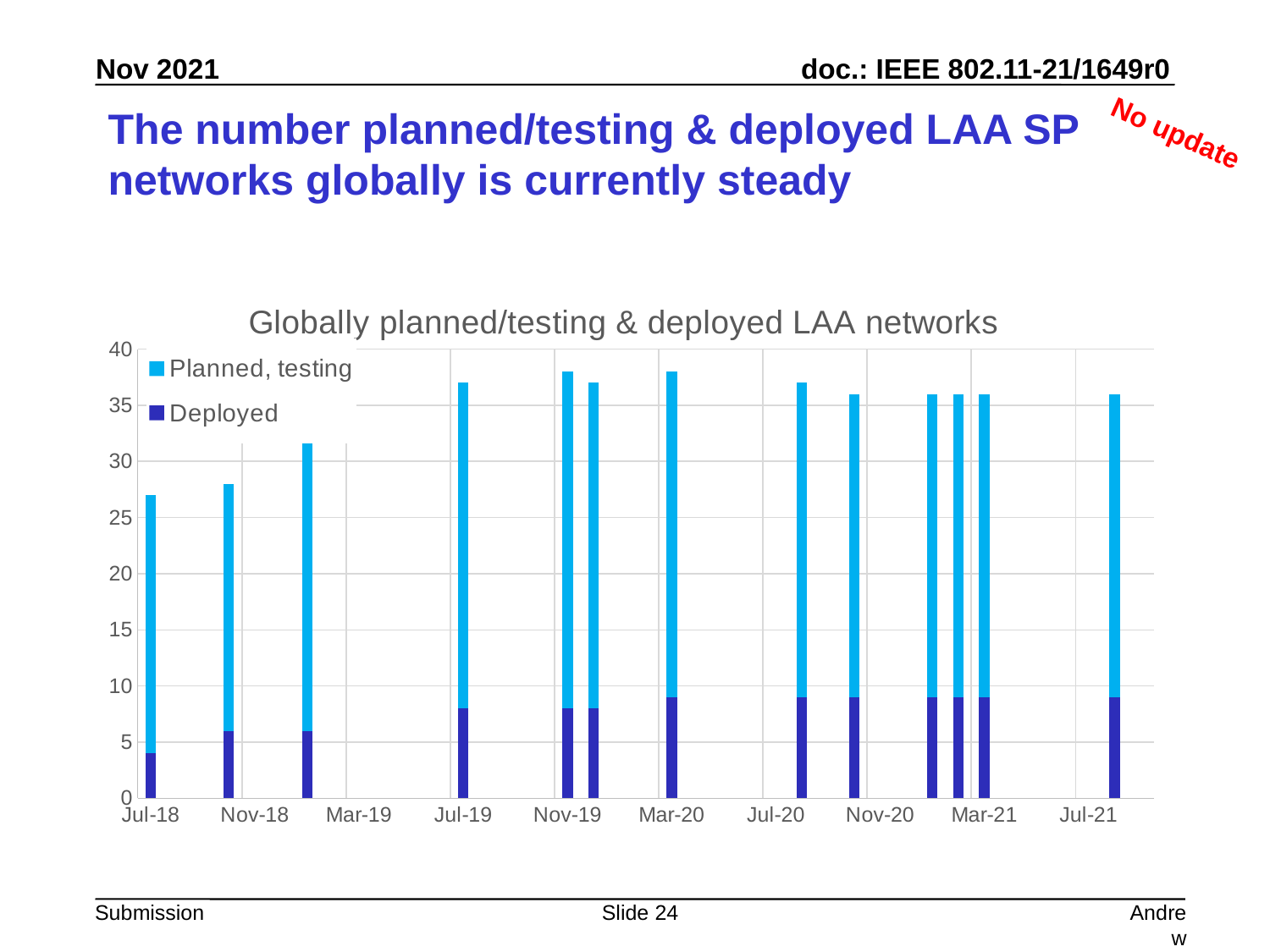
Which bar has the larger total, the one at Jul-18 or the one at Jul-19? Jul-19 How many date labels are shown along the x axis of the chart? 10 How many series does the chart legend list? 2 Is the total height of the bar at Jul-18 greater or less than 30? less Which series is shown in dark blue in the chart? Deployed What is the title of the chart? Globally planned/testing & deployed LAA networks Is the total height of the bar at Jul-19 greater or less than 35? greater Is the Deployed value for the bar at Jul-19 greater or less than 5? greater What kind of chart is shown on the slide? stacked bar chart Do the total bar heights rise or fall from Jul-18 to Jul-19? rise